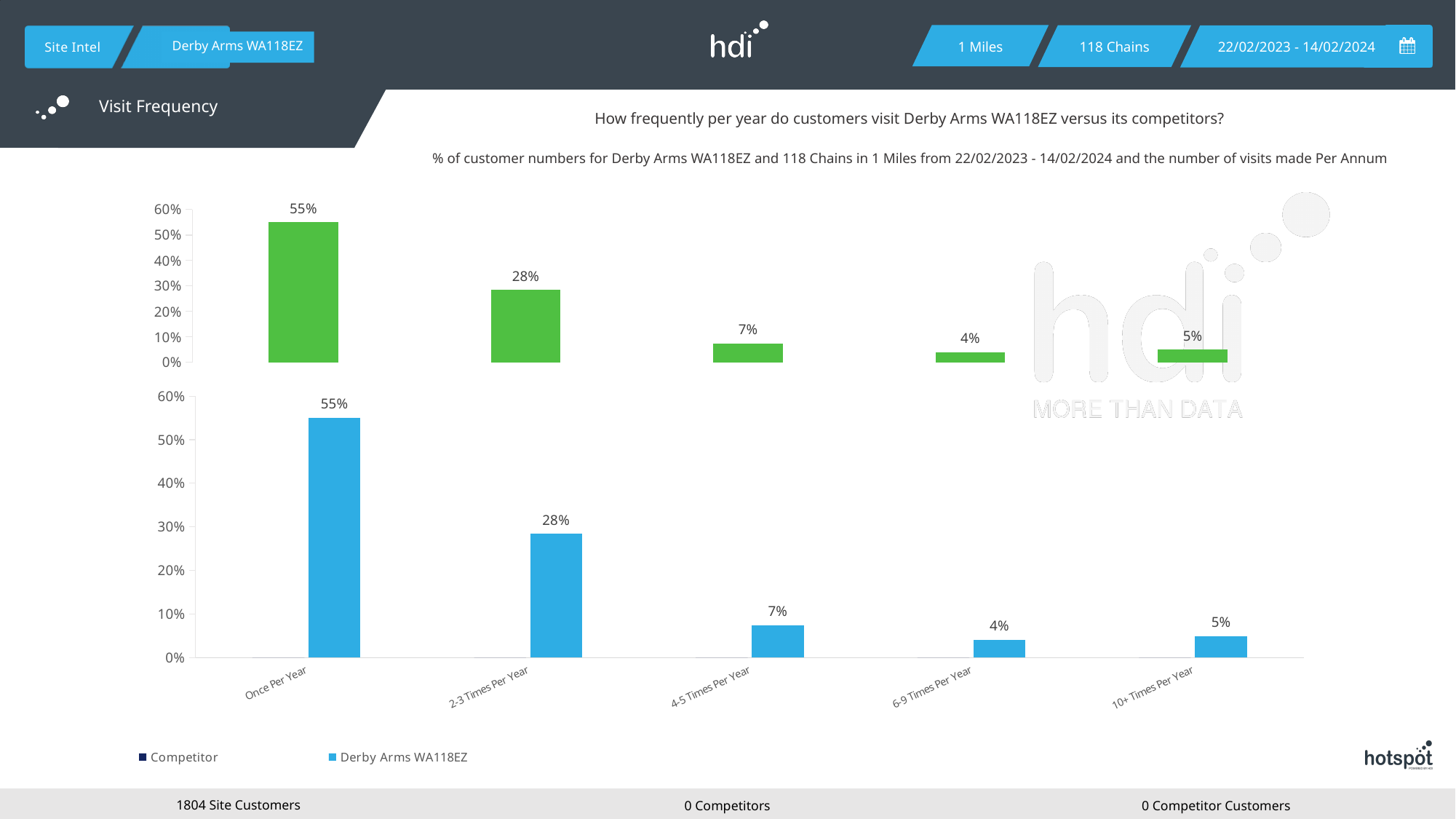
In the bottom chart, which category has the highest value? Once Per Year In the bottom chart, what is the value for Once Per Year? 55% In the bottom chart, what is the value for 6-9 Times Per Year? 4% In the top chart, what is the value of the first (leftmost) bar? 55% How many series does the legend at the bottom of the slide list? 2 In the top chart, what is the value of the fourth bar from the left? 4% In the bottom chart, which category has the lowest value? 6-9 Times Per Year In the bottom chart, what is the value for 2-3 Times Per Year? 28% In the bottom chart, how many categories are shown on the x axis? 5 In the bottom chart, which is larger: the value for 4-5 Times Per Year or 10+ Times Per Year? 4-5 Times Per Year In the bottom chart, what is the difference between the values for Once Per Year and 2-3 Times Per Year? 27% What kind of chart is the bottom chart? Bar chart